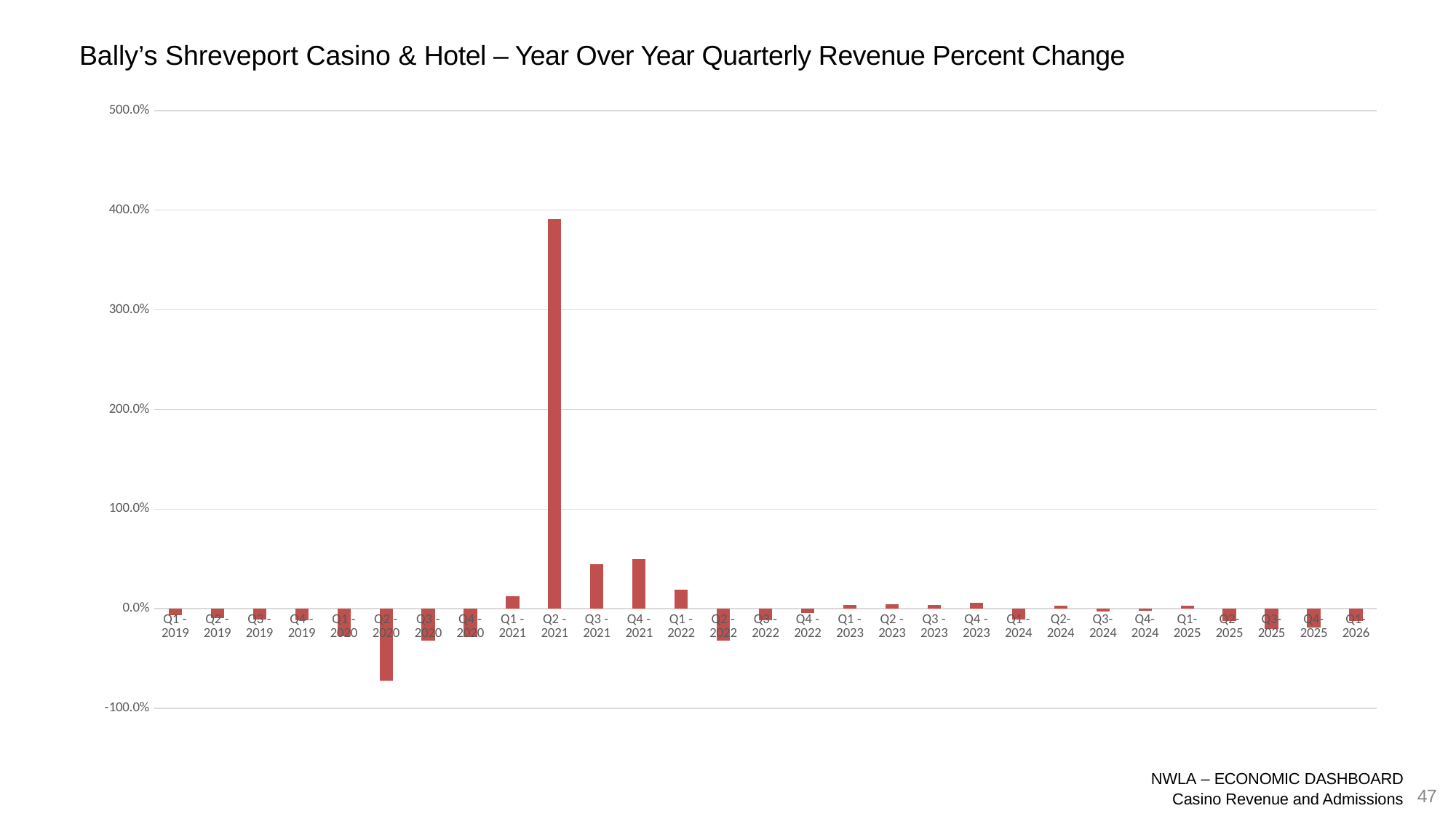
What is the title of the chart? Bally’s Shreveport Casino & Hotel – Year Over Year Quarterly Revenue Percent Change Is the value for Q3 - 2021 greater or less than 0.0%? greater Which is larger, the value for Q4 - 2021 or the value for Q1 - 2022? Q4 - 2021 Which is larger, the value for Q2 - 2021 or the value for Q4 - 2021? Q2 - 2021 Is the value for Q2 - 2020 greater or less than 0.0%? less What kind of chart is shown on the slide? bar chart How many quarters are plotted on the x axis? 29 Is the value for Q4 - 2021 greater or less than 100.0%? less Which quarter has the lowest year-over-year revenue percent change? Q2 - 2020 Which quarter has the highest year-over-year revenue percent change? Q2 - 2021 Which is lower, the value for Q2 - 2020 or the value for Q3 - 2020? Q2 - 2020